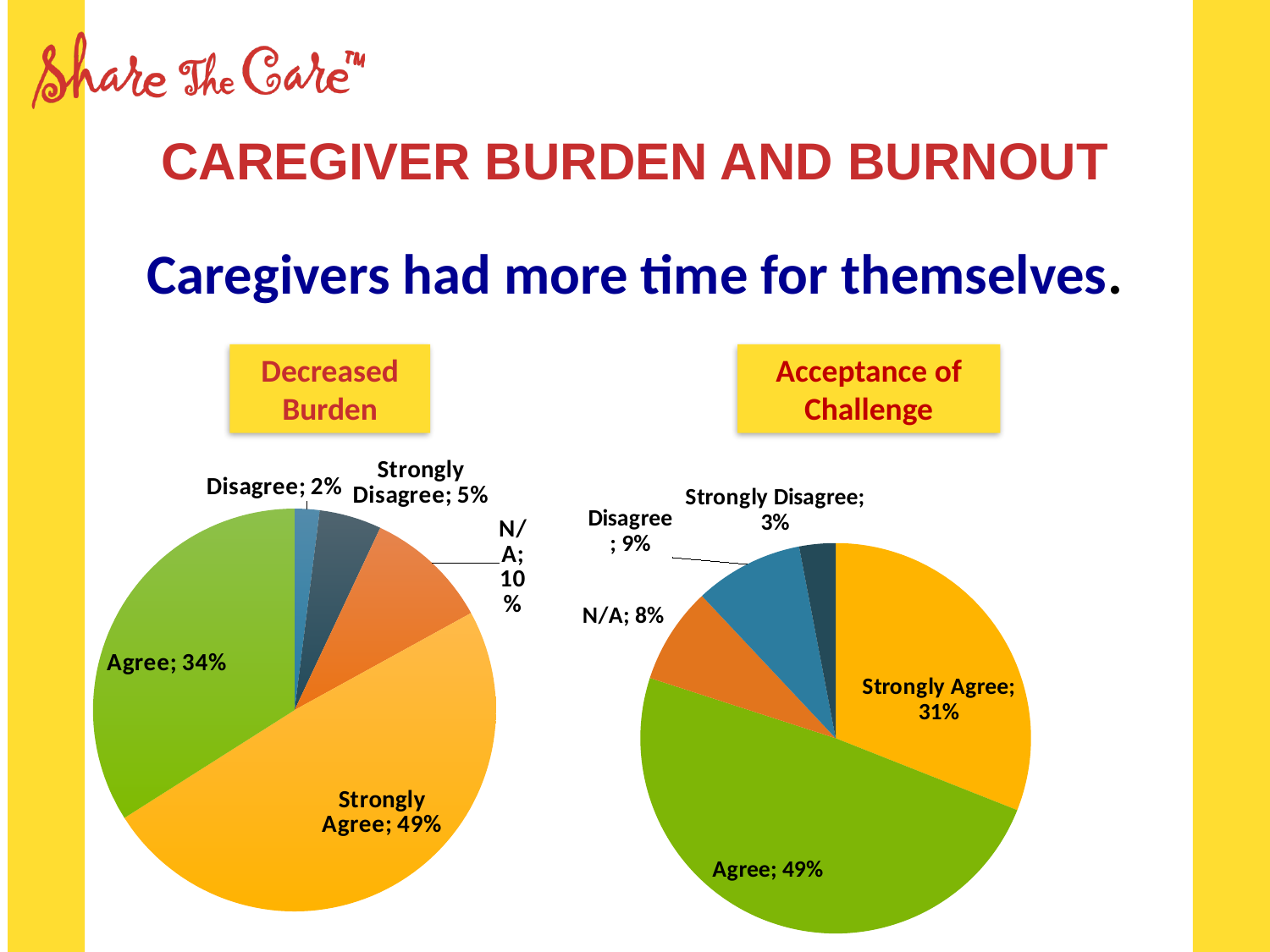
In the Decreased Burden pie chart, what percentage is shown for Agree? 34% In the Acceptance of Challenge pie chart, what percentage is shown for Strongly Agree? 31% In the Decreased Burden pie chart, what percentage is shown for Strongly Agree? 49% In the Acceptance of Challenge pie chart, which is larger, Disagree or N/A? Disagree What type of chart is used for Decreased Burden? Pie chart In the Decreased Burden pie chart, what is the difference between the Strongly Agree and Agree percentages? 15% In the Acceptance of Challenge pie chart, what percentage is shown for Disagree? 9% In the Decreased Burden pie chart, what percentage is shown for N/A? 10% In the Acceptance of Challenge pie chart, which category has the smallest share? Strongly Disagree In the Acceptance of Challenge pie chart, which category has the largest share? Agree In the Decreased Burden pie chart, which category has the smallest share? Disagree In the Decreased Burden pie chart, which category has the largest share? Strongly Agree